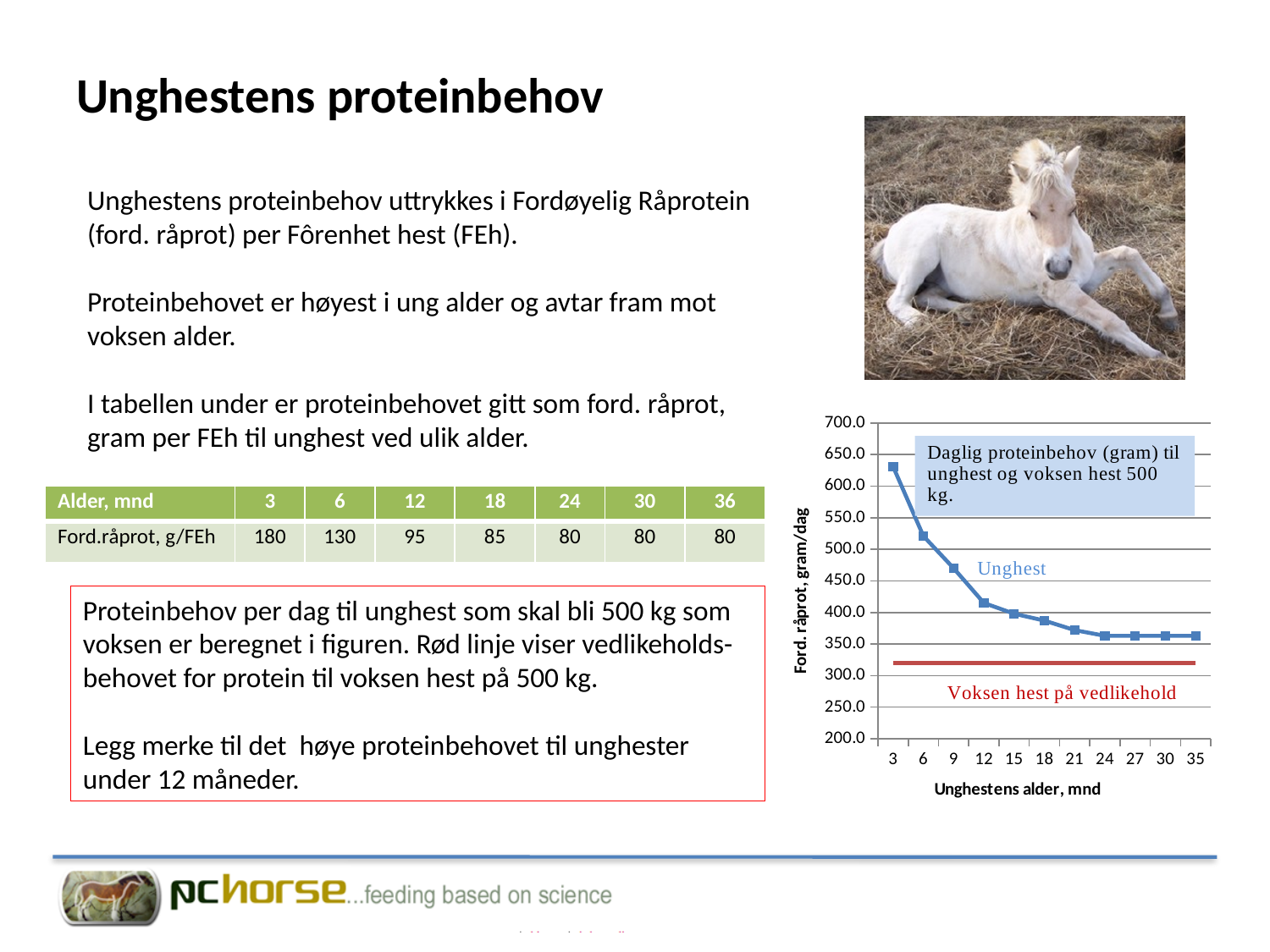
At 3 mnd, which is larger: the Unghest value or the Voksen hest på vedlikehold value? Unghest At which age (mnd) is the Unghest value highest? 3 Is the Unghest value at 6 mnd greater or less than 500.0? greater Is the value of the Voksen hest på vedlikehold line greater or less than 350.0? less Does the Unghest line rise or fall as age increases along the x axis? fall What is the label of the chart's x axis? Unghestens alder, mnd What is the title shown inside the chart? Daglig proteinbehov (gram) til unghest og voksen hest 500 kg. How many data points are plotted on the Unghest line? 11 Is the Unghest value at 35 mnd greater or less than 400.0? less What kind of chart is shown on the slide? line chart How many series are plotted in the chart? 2